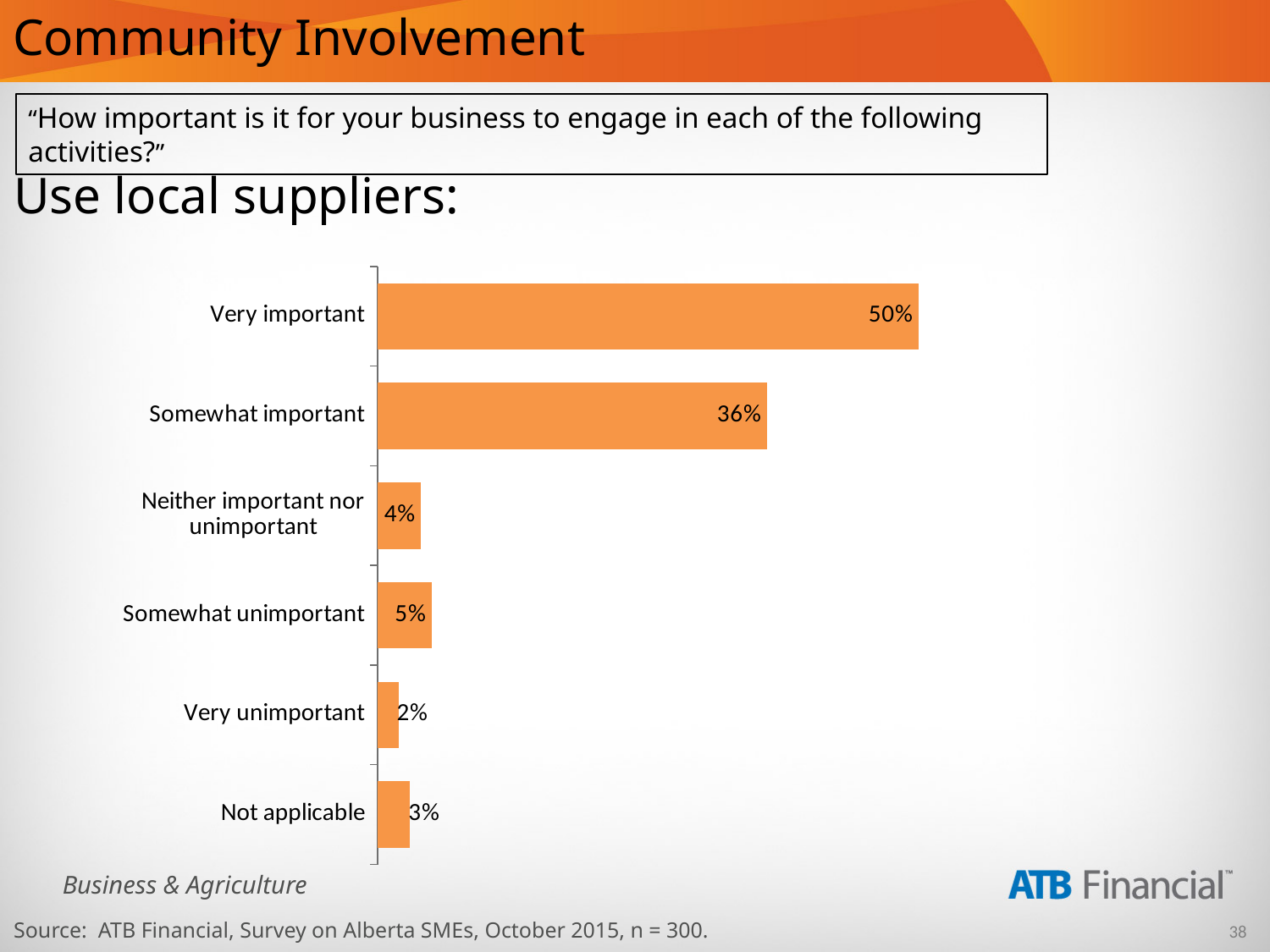
What activity does the chart on this slide refer to? Use local suppliers Which category has the highest value? Very important What is the value for 'Neither important nor unimportant'? 4% Which is larger, 'Somewhat unimportant' or 'Neither important nor unimportant'? Somewhat unimportant What is the combined value of 'Very important' and 'Somewhat important'? 86% Which category has the lowest value? Very unimportant What is the difference between the 'Very important' and 'Somewhat important' values? 14% What is the value for 'Not applicable'? 3% What is the value for 'Somewhat important'? 36% What kind of chart is shown on the slide? Bar chart What percentage of respondents said using local suppliers is 'Very important'? 50% How many categories are shown in the chart? 6